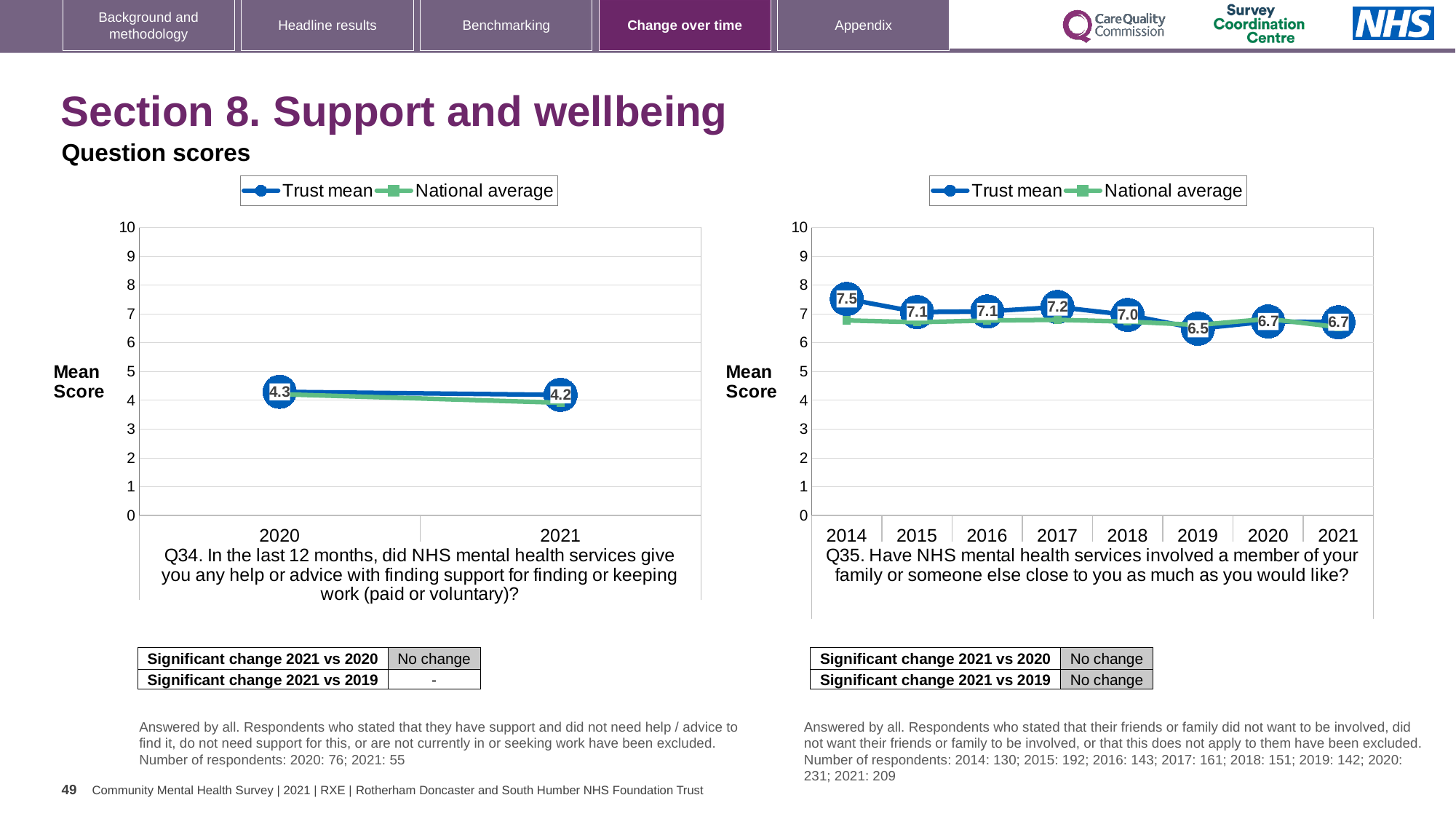
In the Q34 chart on the left, what is the Trust mean for 2020? 4.3 How many series does the legend of the Q34 chart on the left list? 2 In the Q35 chart on the right, which year has the highest Trust mean? 2014 How many years are shown on the x axis of the Q35 chart on the right? 8 In the Q35 chart on the right, what is the Trust mean for 2014? 7.5 In the Q34 chart on the left, is the Trust mean higher in 2020 or in 2021? 2020 In the Q35 chart on the right, what is the difference between the Trust mean in 2014 and in 2021? 0.8 What type of chart is used for Q35 on the right? Line chart In the Q35 chart on the right, which year has the lowest Trust mean? 2019 In the Q34 chart on the left, what is the Trust mean for 2021? 4.2 In the Q35 chart on the right, is the Trust mean for 2014 greater or less than 7? greater In the Q35 chart on the right, what is the Trust mean for 2019? 6.5